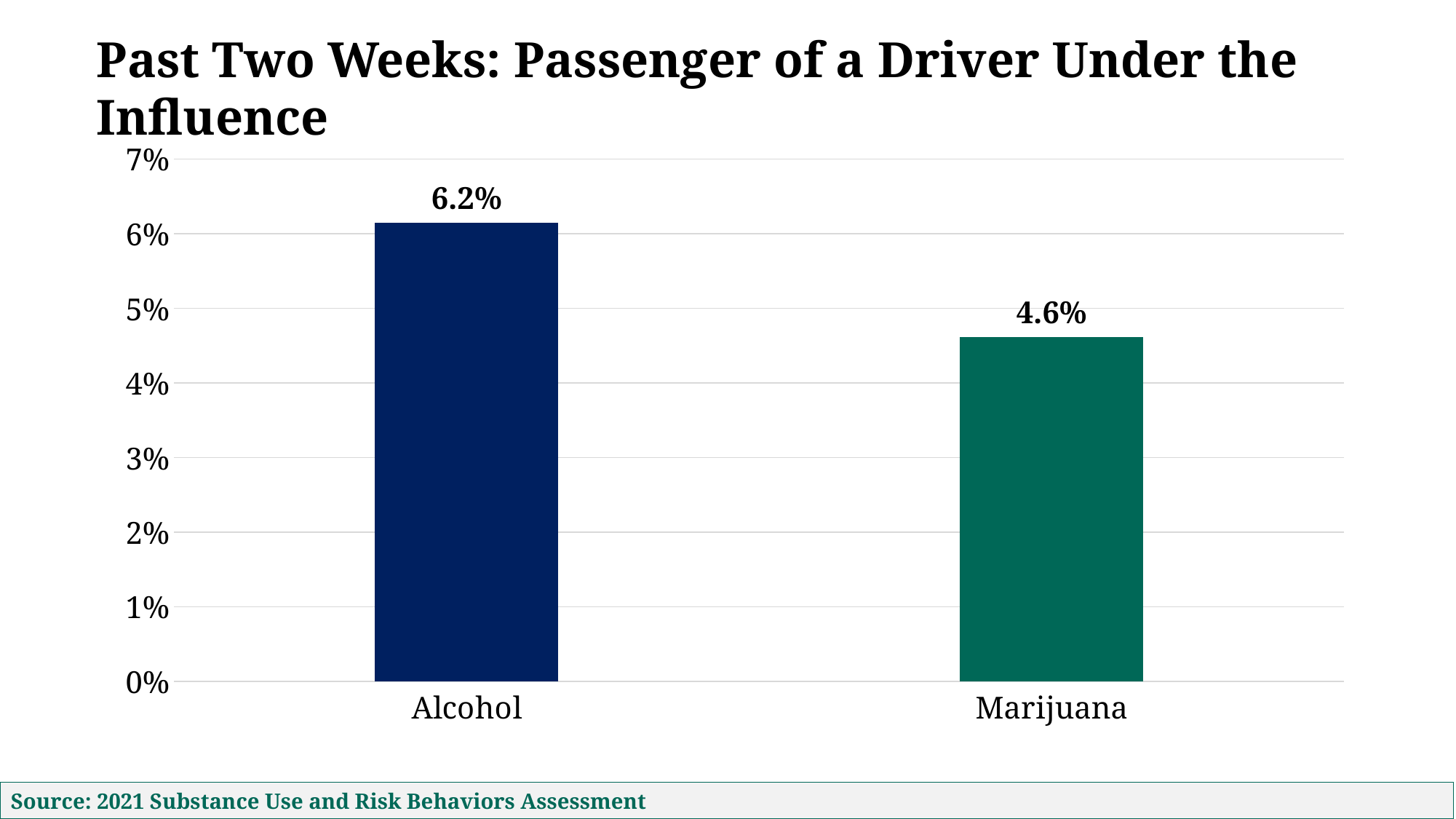
What is the title of the chart? Past Two Weeks: Passenger of a Driver Under the Influence Which category has the lowest value? Marijuana Is the value for Alcohol greater or less than 6%? greater What source is cited at the bottom of the slide? 2021 Substance Use and Risk Behaviors Assessment Is the value for Marijuana greater or less than 5%? less Which category has the highest value? Alcohol What is the difference between the values for Alcohol and Marijuana? 1.6% How many categories are shown in the chart? 2 Which is larger, the value for Alcohol or the value for Marijuana? Alcohol What kind of chart is shown on the slide? Bar chart What is the value for Alcohol? 6.2% What is the value for Marijuana? 4.6%